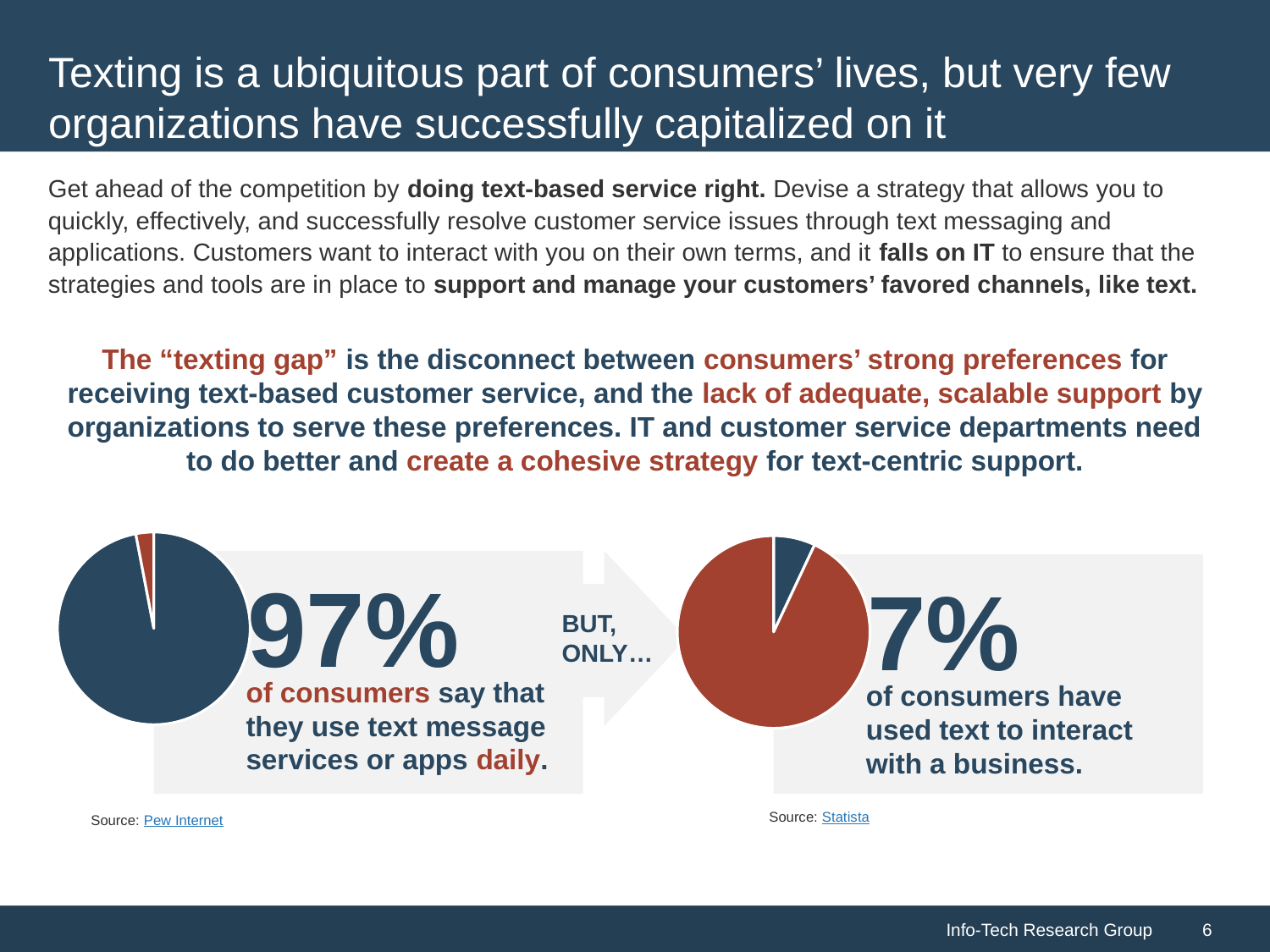
Which pie chart shows the larger highlighted percentage, the left one (consumers using text daily) or the right one (consumers who have used text with a business)? the left one How many slices does the left pie chart have? 2 In the left pie chart, what share of the pie does the large dark blue slice represent? 97% What kind of chart is the chart on the left of the slide? pie chart What source is cited for the right pie chart? Statista In the right pie chart, what percentage of consumers have used text to interact with a business? 7% What is the difference in percentage points between the value shown on the left pie chart (97%) and the value shown on the right pie chart (7%)? 90 percentage points In the left pie chart, what percentage of consumers say they use text message services or apps daily? 97% How many slices does the right pie chart have? 2 What kind of chart is the chart on the right of the slide? pie chart In the right pie chart, is the percentage of consumers who have used text to interact with a business greater or less than 50%? less What colour is the large slice in the left pie chart? dark blue